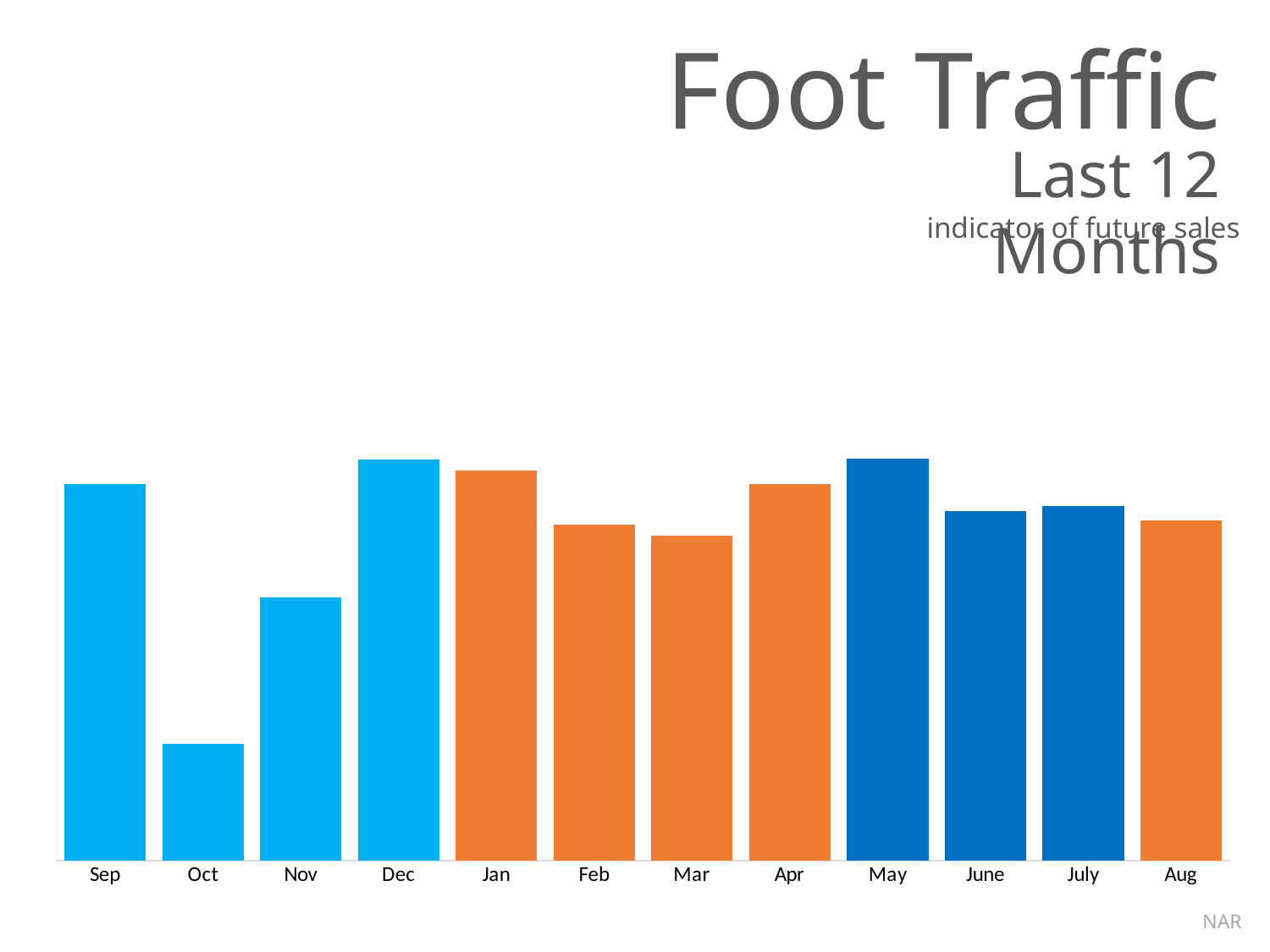
Which is larger, the bar for May or the bar for June? May Which is larger, the bar for Nov or the bar for Aug? Aug Which month has the lowest foot traffic bar? Oct From Jan to Mar, do the bars rise or fall? fall Which is larger, the bar for Jan or the bar for Feb? Jan How many months are plotted on the chart? 12 What source is credited at the bottom right of the slide? NAR What is the main title of the slide? Foot Traffic What kind of chart is shown on the slide? bar chart